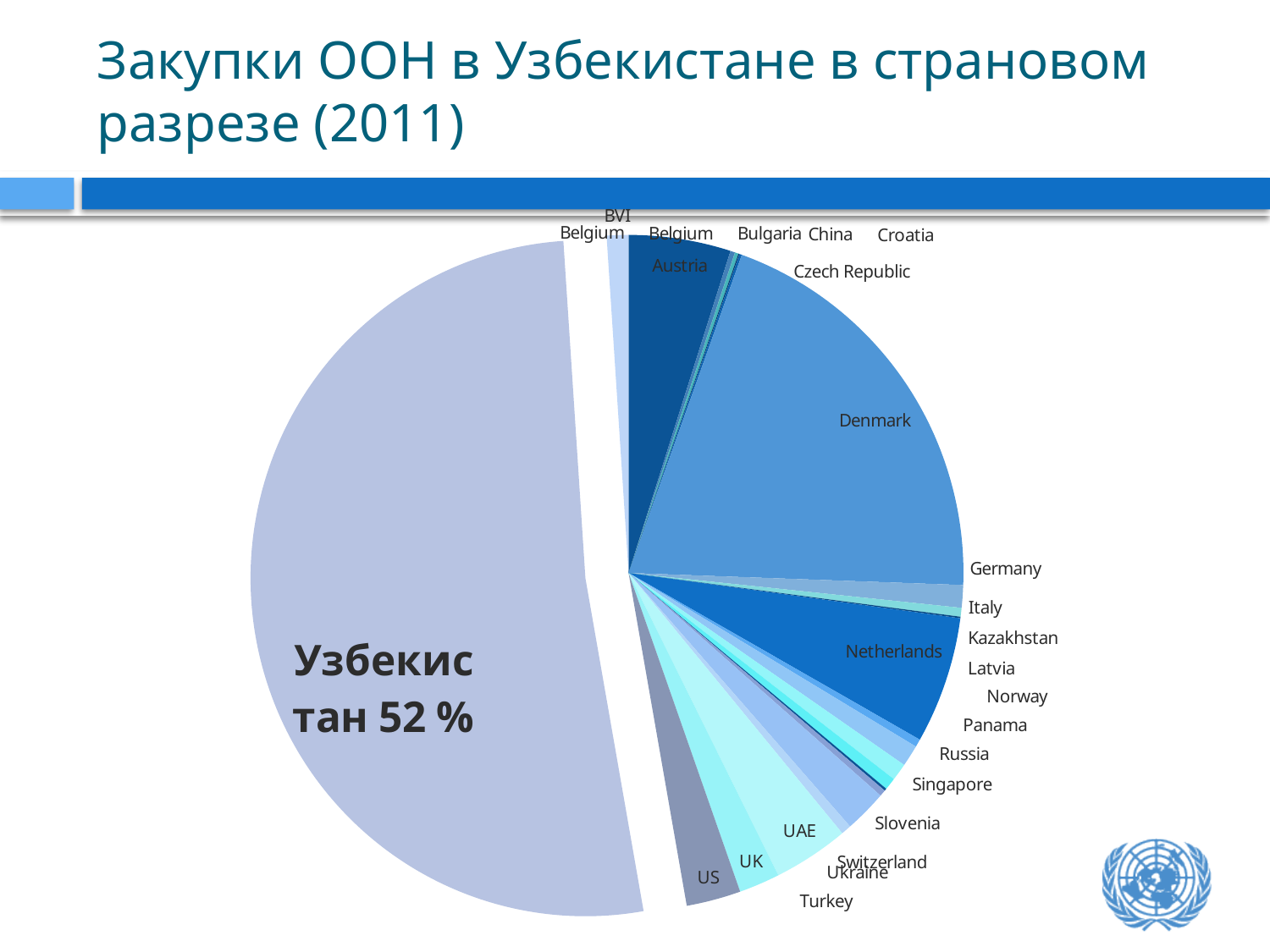
What share of the pie does Узбекистан (Uzbekistan) account for? 52 % Which slice is larger, Denmark or Austria? Denmark What kind of chart is shown on the slide? pie chart Which year does the chart's title refer to? 2011 Is the share for Узбекистан greater or less than 50%? greater Which country has the largest slice of the pie? Узбекистан What is the title of the slide containing the pie chart? Закупки ООН в Узбекистане в страновом разрезе (2011) Which slice is larger, Denmark or Netherlands? Denmark Which slice is larger, Узбекистан or Denmark? Узбекистан